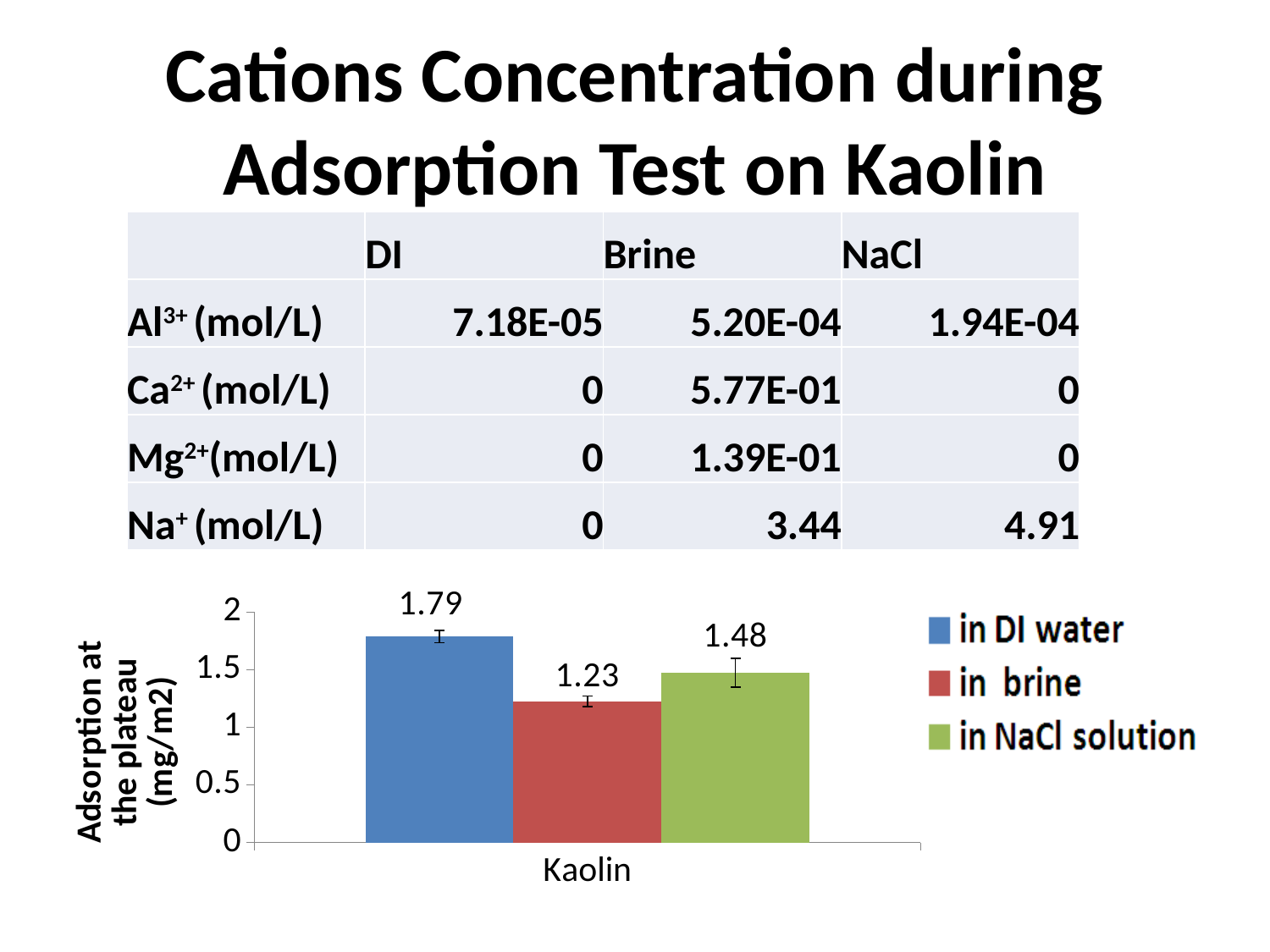
What is the label on the vertical axis of the chart? Adsorption at the plateau (mg/m2) Is the adsorption for Kaolin in brine greater or less than 1.5? less Which series has the highest adsorption at the plateau for Kaolin? in DI water What is the adsorption at the plateau for Kaolin in brine? 1.23 What is the adsorption at the plateau for Kaolin in NaCl solution? 1.48 What is the adsorption at the plateau for Kaolin in DI water? 1.79 Which series has the lowest adsorption at the plateau for Kaolin? in brine What is the difference between the adsorption in DI water and in brine for Kaolin? 0.56 What kind of chart is shown on the slide? bar chart What is the difference between the adsorption in NaCl solution and in brine for Kaolin? 0.25 How many series does the chart legend list? 3 Which is larger for Kaolin: adsorption in NaCl solution or in brine? in NaCl solution